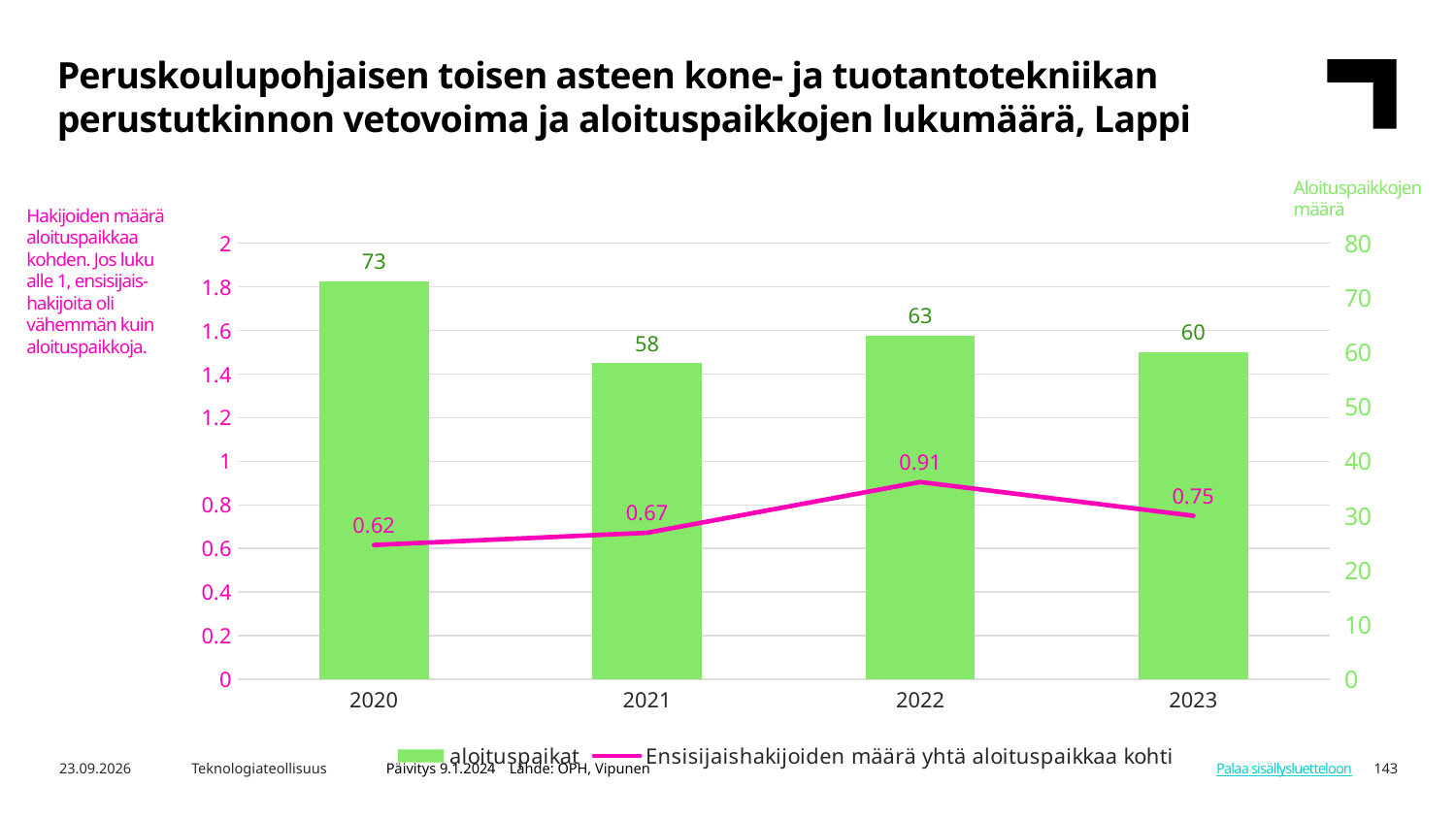
What kind of chart is used to show aloituspaikat? bar chart How many aloituspaikat were there in 2020? 73 Which year had the highest number of aloituspaikat? 2020 Which year had the lowest value of Ensisijaishakijoiden määrä yhtä aloituspaikkaa kohti? 2020 How many series does the legend list? 2 Did the value of Ensisijaishakijoiden määrä yhtä aloituspaikkaa kohti rise or fall from 2020 to 2022? rise How many years are shown on the x axis? 4 Is the value of Ensisijaishakijoiden määrä yhtä aloituspaikkaa kohti in 2023 greater or less than 1? less Which year had more aloituspaikat, 2022 or 2023? 2022 What is the difference in aloituspaikat between 2020 and 2021? 15 What was the value of Ensisijaishakijoiden määrä yhtä aloituspaikkaa kohti in 2022? 0.91 How many aloituspaikat were there in 2023? 60